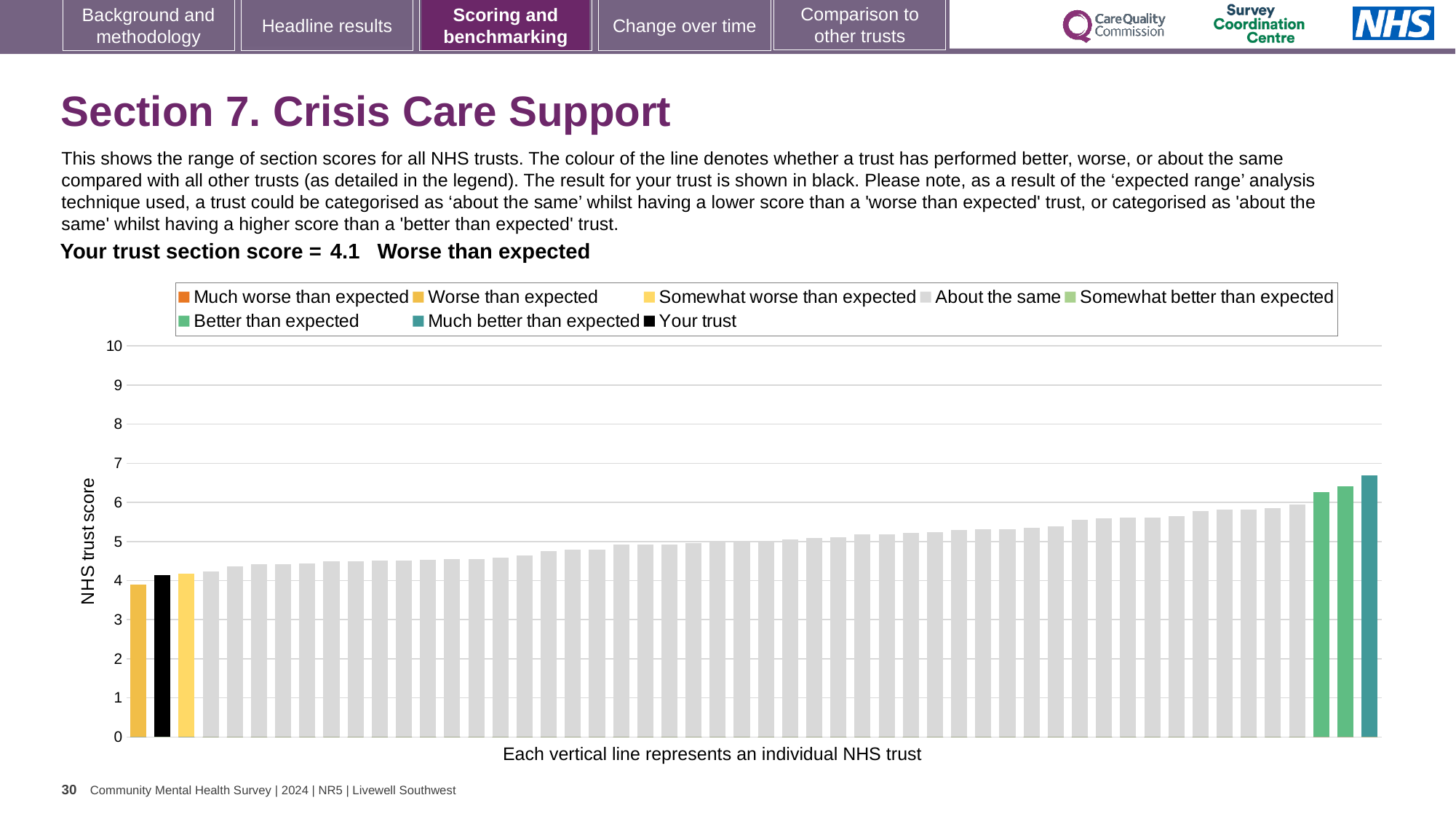
Which performance category is your trust placed in for Crisis Care Support? Worse than expected What is the label on the vertical axis of the chart? NHS trust score How many bars are coloured as 'Much better than expected' (teal)? 1 Is the value of the tallest bar in the chart greater or less than 6? greater Is the bar for your trust higher or lower than the rightmost bar in the chart? lower What is the section score for your trust shown on the slide? 4.1 Is the value for your trust (the black bar) greater or less than 5? less Is the value of the leftmost bar in the chart greater or less than 5? less Do the trust scores rise or fall moving from left to right along the x axis? rise How many entries does the chart legend list? 8 What kind of chart is shown on the slide? bar chart